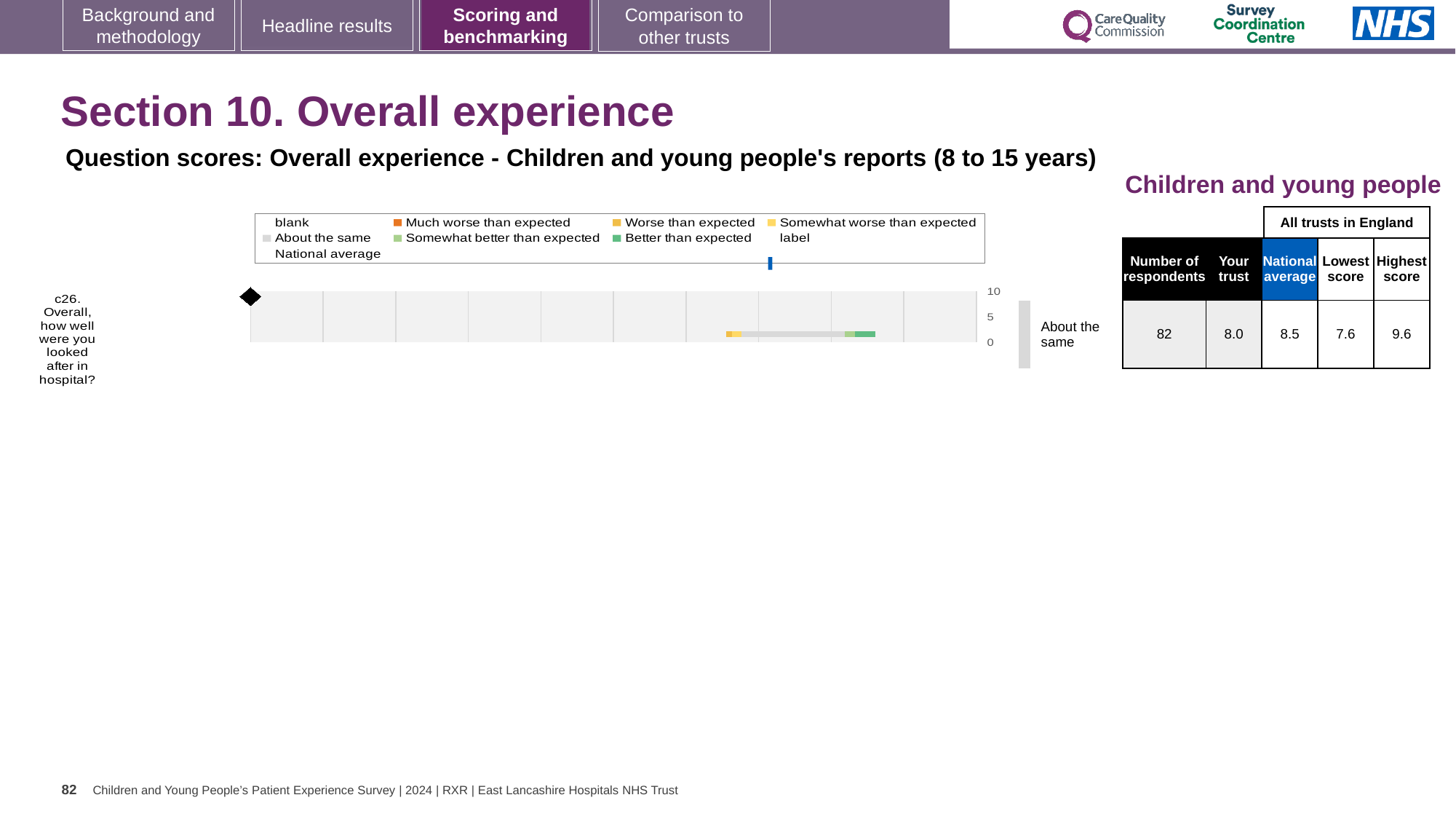
In the table beside the chart, which is larger for question c26: the 'Your trust' score or the national average? National average Which question is plotted in the chart? c26. Overall, how well were you looked after in hospital? In the table beside the chart, how many respondents answered question c26? 82 In the table beside the chart, what is the difference between the highest score and the lowest score for question c26? 2.0 In the table beside the chart, what is the 'Your trust' score for question c26? 8.0 In the table beside the chart, what is the national average score for question c26? 8.5 What benchmark category is shown next to the bar for question c26? About the same How many entries does the chart legend list? 9 How many questions (categories) are plotted in the chart? 1 What kind of chart is shown on the slide? bar chart In the table beside the chart, what is the highest score among all trusts in England for question c26? 9.6